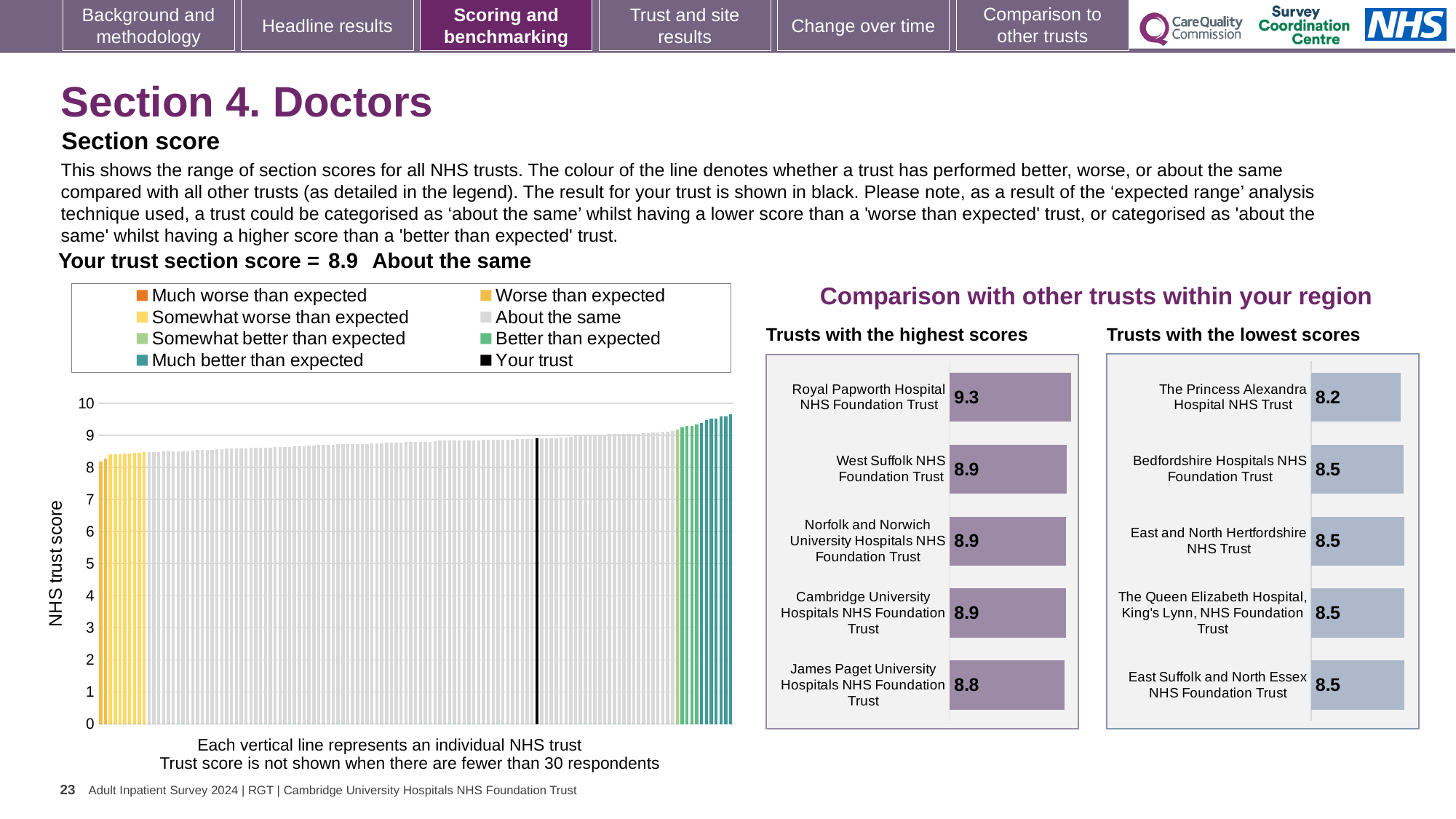
In the 'Trusts with the highest scores' chart, which trust has the lowest score? James Paget University Hospitals NHS Foundation Trust What kind of chart is the NHS trust score chart on the left? Bar chart In the NHS trust score chart on the left, how many entries does the legend list? 8 In the 'Trusts with the lowest scores' chart, which trust has the lowest score? The Princess Alexandra Hospital NHS Trust In the 'Trusts with the highest scores' chart, what is the score for Royal Papworth Hospital NHS Foundation Trust? 9.3 In the NHS trust score chart on the left, is the value for the black 'Your trust' bar greater or less than 8? greater In the 'Trusts with the highest scores' chart, which trust has the highest score? Royal Papworth Hospital NHS Foundation Trust In the 'Trusts with the lowest scores' chart, what is the difference between the scores of Bedfordshire Hospitals NHS Foundation Trust and The Princess Alexandra Hospital NHS Trust? 0.3 In the 'Trusts with the lowest scores' chart, which has the larger score: East Suffolk and North Essex NHS Foundation Trust or The Princess Alexandra Hospital NHS Trust? East Suffolk and North Essex NHS Foundation Trust In the 'Trusts with the highest scores' chart, what is the difference between the scores of Royal Papworth Hospital NHS Foundation Trust and James Paget University Hospitals NHS Foundation Trust? 0.5 In the 'Trusts with the highest scores' chart, how many trusts are shown? 5 In the 'Trusts with the lowest scores' chart, what is the score for The Princess Alexandra Hospital NHS Trust? 8.2